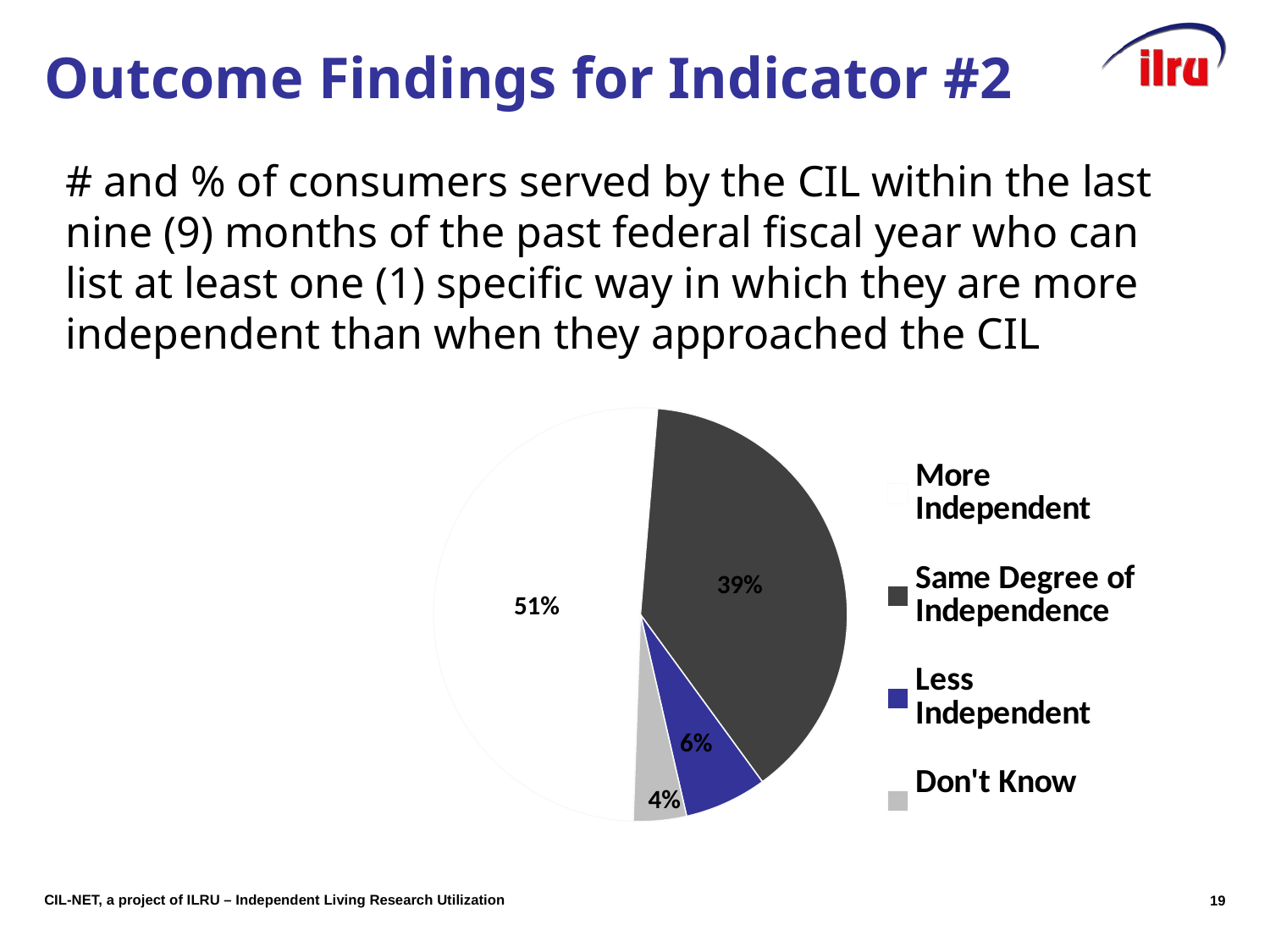
How many categories does the pie chart show? 4 What percentage of consumers are shown as Same Degree of Independence? 39% What colour is the slice for Less Independent? blue Which is larger, the share for Less Independent or the share for Don't Know? Less Independent What is the combined share of Less Independent and Don't Know? 10% What is the difference in percentage points between More Independent and Same Degree of Independence? 12 What percentage of consumers are shown as More Independent? 51% Which category has the largest share of the pie? More Independent Which category has the smallest share of the pie? Don't Know What percentage of consumers are shown as Less Independent? 6% What percentage of consumers are shown as Don't Know? 4% What kind of chart is shown on the slide? pie chart